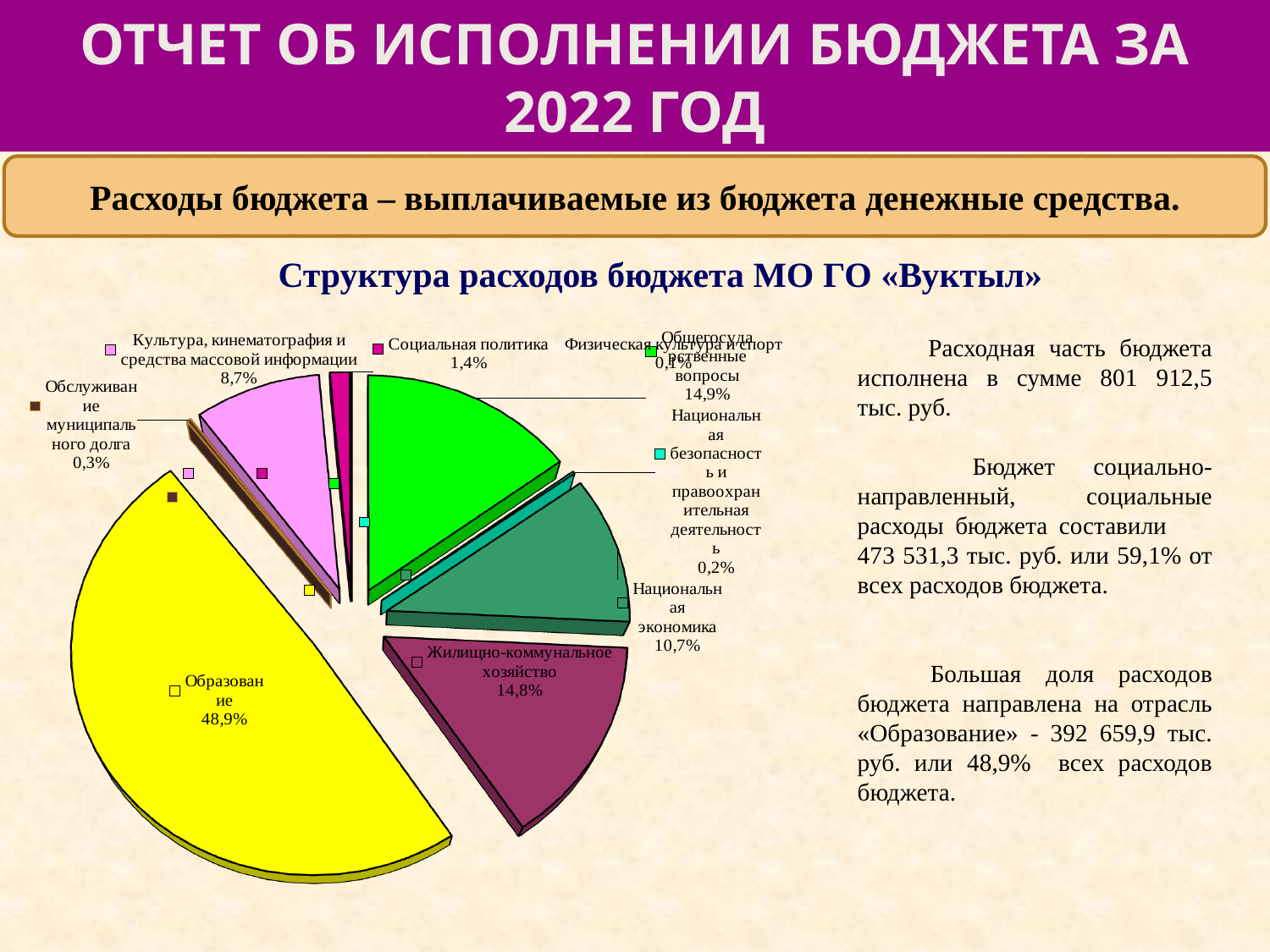
What share of the pie does Образование have? 48,9% What share of the pie does Социальная политика have? 1,4% What share of the pie does Национальная экономика have? 10,7% What share of the pie does Обслуживание муниципального долга have? 0,3% What share of the pie does Общегосударственные вопросы have? 14,9% What is the title of the chart? Структура расходов бюджета МО ГО «Вуктыл» What share of the pie does Жилищно-коммунальное хозяйство have? 14,8% What kind of chart is shown on the slide? Pie chart Which category has the largest share of the pie? Образование How many categories are shown in the pie chart? 9 What share of the pie does Культура, кинематография и средства массовой информации have? 8,7% Which has the larger share: Национальная экономика or Культура, кинематография и средства массовой информации? Национальная экономика